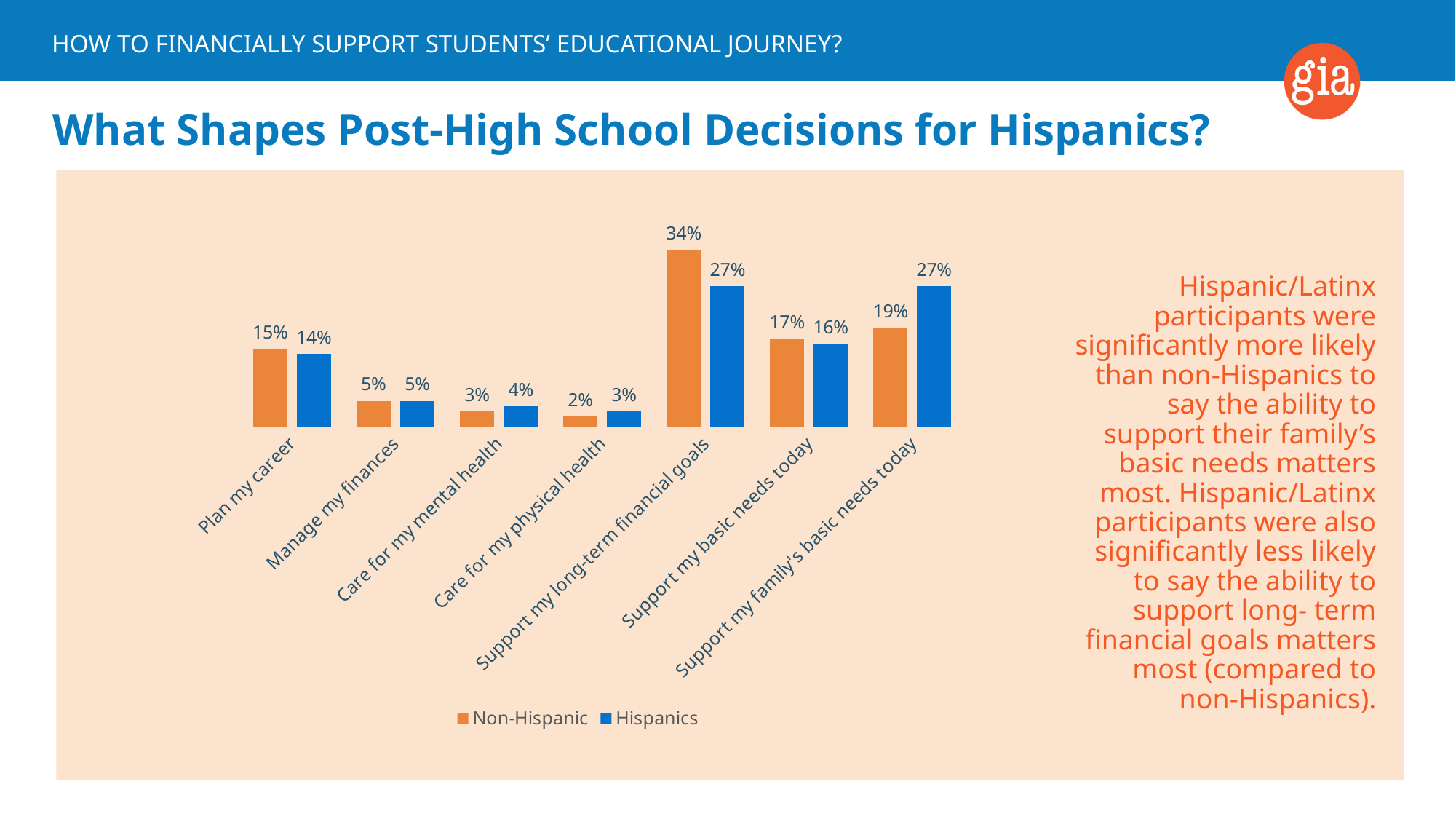
How many categories are shown on the x axis? 7 What is the Hispanics value for 'Support my family's basic needs today'? 27% What is the Non-Hispanic value for 'Care for my physical health'? 2% What is the Hispanics value for 'Plan my career'? 14% For 'Support my basic needs today', which is larger: the Non-Hispanic value or the Hispanics value? Non-Hispanic How many series does the legend list? 2 What is the Non-Hispanic value for 'Support my long-term financial goals'? 34% What kind of chart is shown on the slide? Bar chart What is the difference between the Non-Hispanic and Hispanics values for 'Support my long-term financial goals'? 7% Which category has the highest Non-Hispanic value? Support my long-term financial goals What is the difference between the Hispanics and Non-Hispanic values for 'Support my family's basic needs today'? 8% Which category has the lowest Non-Hispanic value? Care for my physical health